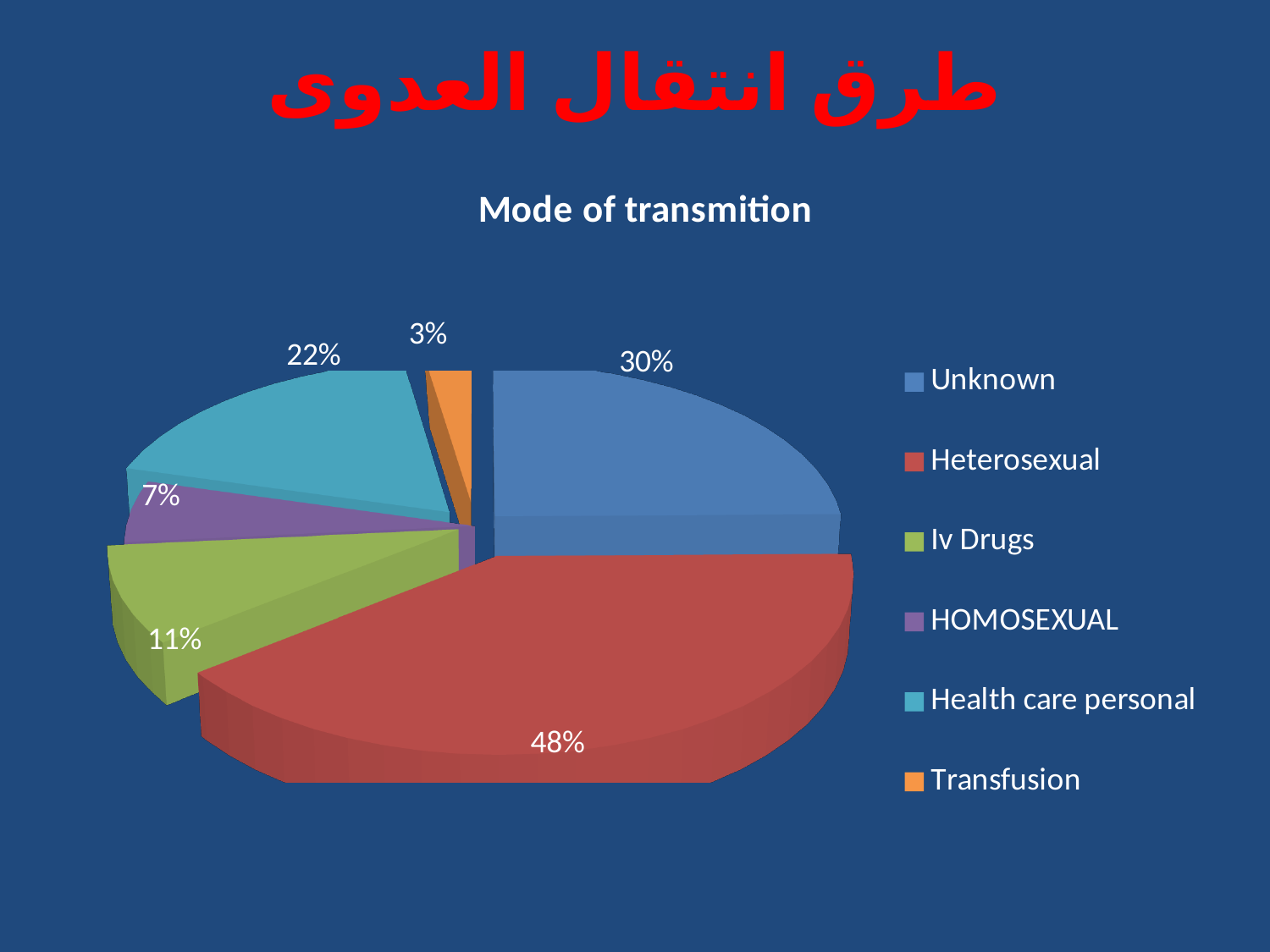
What percentage is shown for Iv Drugs? 11% Which category has the smallest slice? Transfusion What percentage is shown for Health care personal? 22% What is the chart's title? Mode of transmition Which category has the largest slice? Heterosexual What percentage is shown for Unknown? 30% Which is larger, the slice for Unknown or the slice for Health care personal? Unknown How many categories does the legend list? 6 What kind of chart is shown on the slide? pie chart What percentage is shown for Transfusion? 3% What is the difference in percentage points between the Heterosexual slice and the HOMOSEXUAL slice? 41 What percentage is shown for Heterosexual? 48%